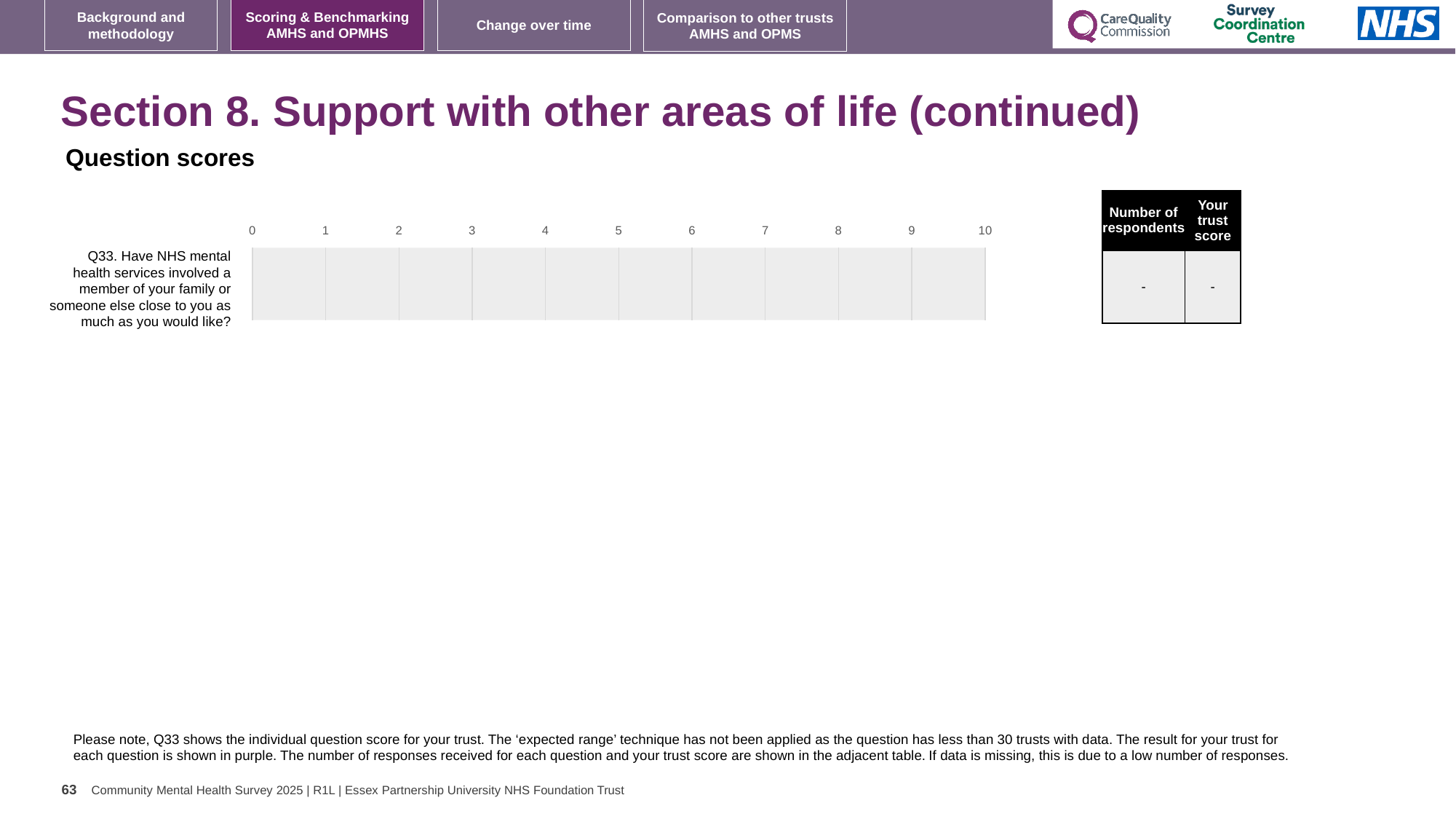
What is shown in the 'Your trust score' column for Q33 in the adjacent table? - What is shown in the 'Number of respondents' column for Q33 in the adjacent table? - What is the highest value shown on the x axis of the Question scores chart? 10 What kind of chart is used for the Question scores on this slide? bar chart How many questions are listed as categories on the Question scores chart? 1 Which question number is shown on the Question scores chart? Q33 What is the lowest value shown on the x axis of the Question scores chart? 0